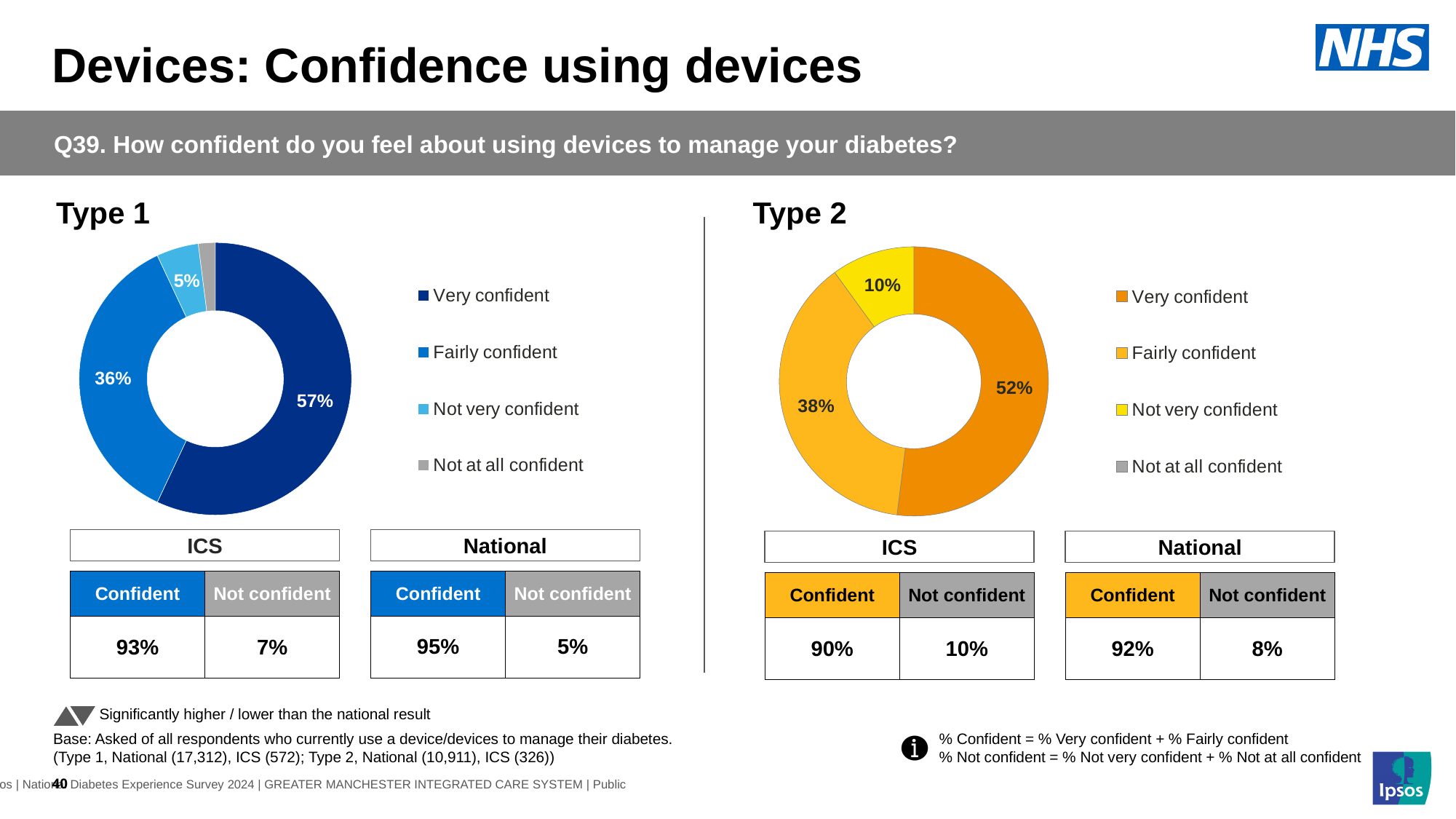
In the Type 2 chart, which is larger: fairly confident or not very confident? Fairly confident In the Type 1 chart, what percentage of respondents are very confident? 57% In the Type 1 chart, what percentage of respondents are fairly confident? 36% How many categories does the legend of the Type 1 chart list? 4 In the Type 2 chart, what percentage of respondents are very confident? 52% In the Type 2 chart, which category has the largest share? Very confident In the Type 1 chart, what is the difference in percentage points between very confident and fairly confident? 21 percentage points In the Type 2 chart, what percentage of respondents are not very confident? 10% What kind of chart is used for Type 1? Pie (donut) chart In the Type 1 chart, what percentage of respondents are not very confident? 5% In the Type 1 chart, which category has the smallest share? Not at all confident In the Type 2 chart, what is the difference in percentage points between very confident and fairly confident? 14 percentage points